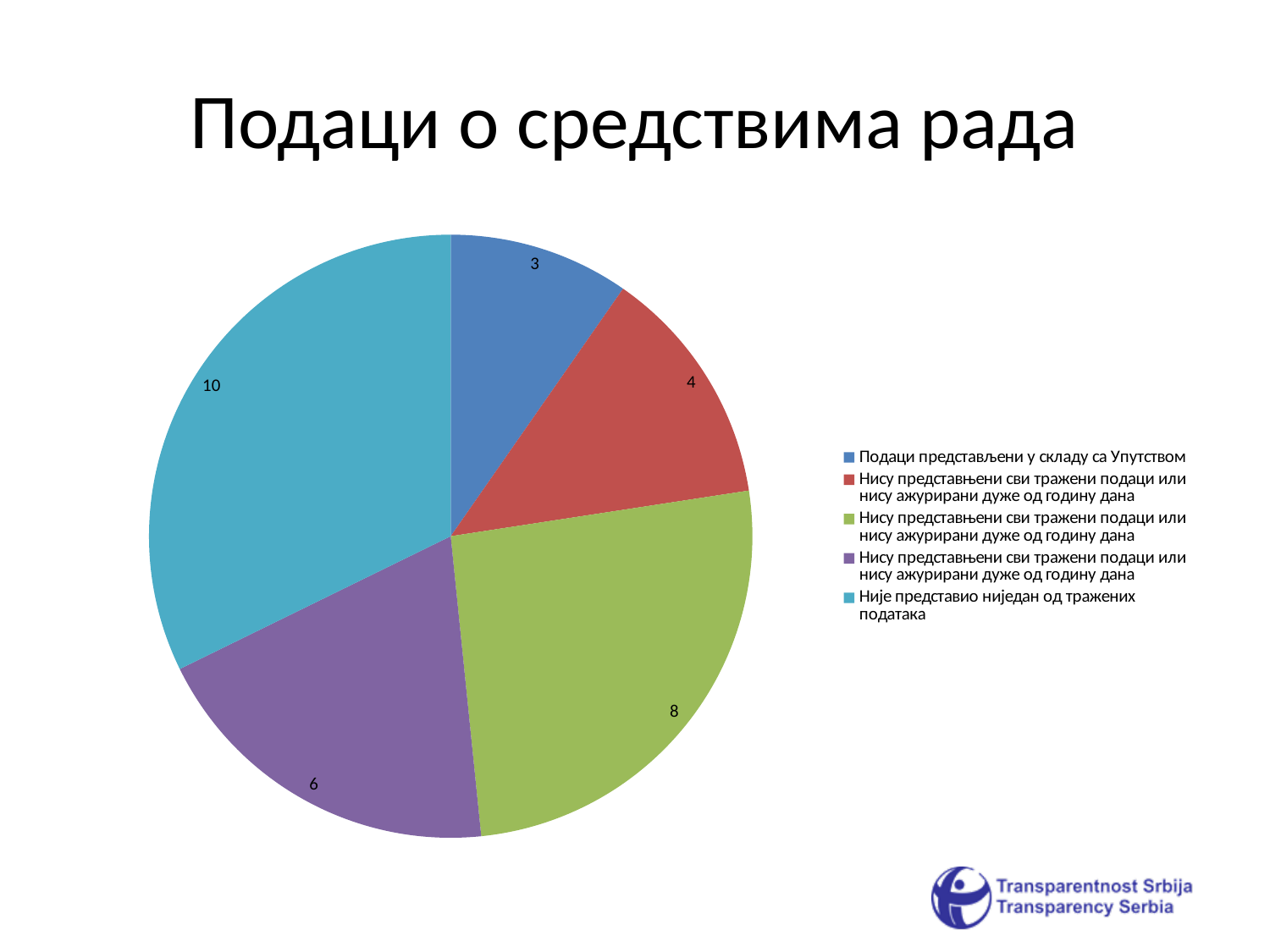
What is the value of the slice labelled "Није представио ниједан од тражених података"? 10 How many entries does the legend of the pie chart list? 5 What is the total of all the slice values in the pie chart? 31 Which slice of the pie chart is the largest? Није представио ниједан од тражених података (10) What kind of chart is shown on the slide? Pie chart How many slices does the pie chart have? 5 What is the difference between the largest slice (10) and the smallest slice (3)? 7 What is the title of the slide containing the pie chart? Подаци о средствима рада What is the value of the slice labelled "Подаци представљени у складу са Упутством"? 3 Which is larger, the green slice or the purple slice? The green slice (8) Which slice of the pie chart is the smallest? Подаци представљени у складу са Упутством (3) What is the value of the red slice in the pie chart? 4